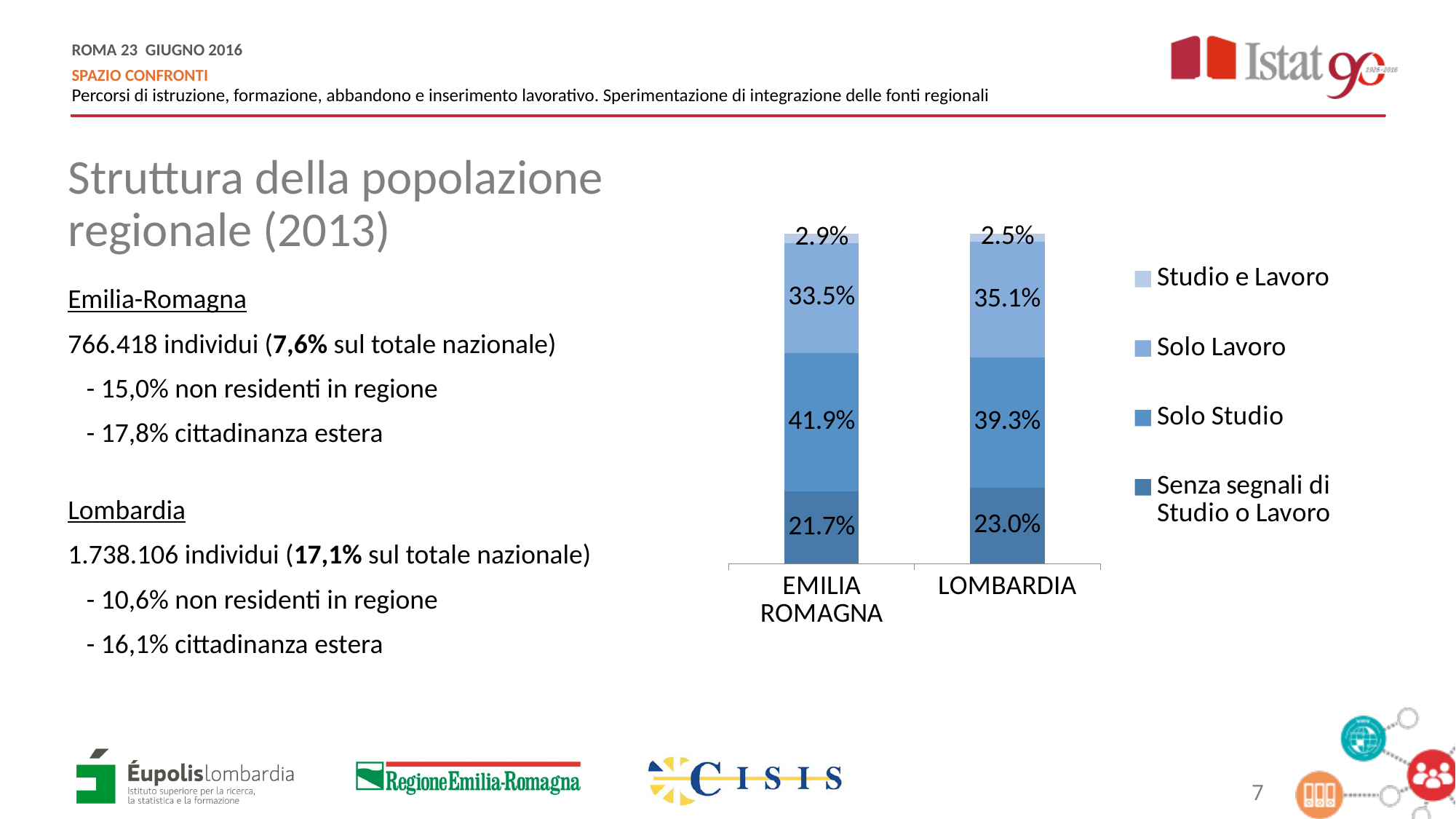
What is the total of the EMILIA ROMAGNA stacked bar? 100.0% What is the value for Studio e Lavoro in EMILIA ROMAGNA? 2.9% What is the value for Solo Lavoro in LOMBARDIA? 35.1% How many series does the legend list? 4 Which segment is the smallest in the EMILIA ROMAGNA bar? Studio e Lavoro What is the difference between the Solo Studio values for EMILIA ROMAGNA and LOMBARDIA? 2.6 percentage points How many categories are shown on the x axis? 2 What is the value for Solo Studio in EMILIA ROMAGNA? 41.9% Which segment is the largest in the LOMBARDIA bar? Solo Studio Which region has the larger value for Senza segnali di Studio o Lavoro? LOMBARDIA What is the value for Senza segnali di Studio o Lavoro in LOMBARDIA? 23.0% What kind of chart is shown on the slide? Stacked bar chart